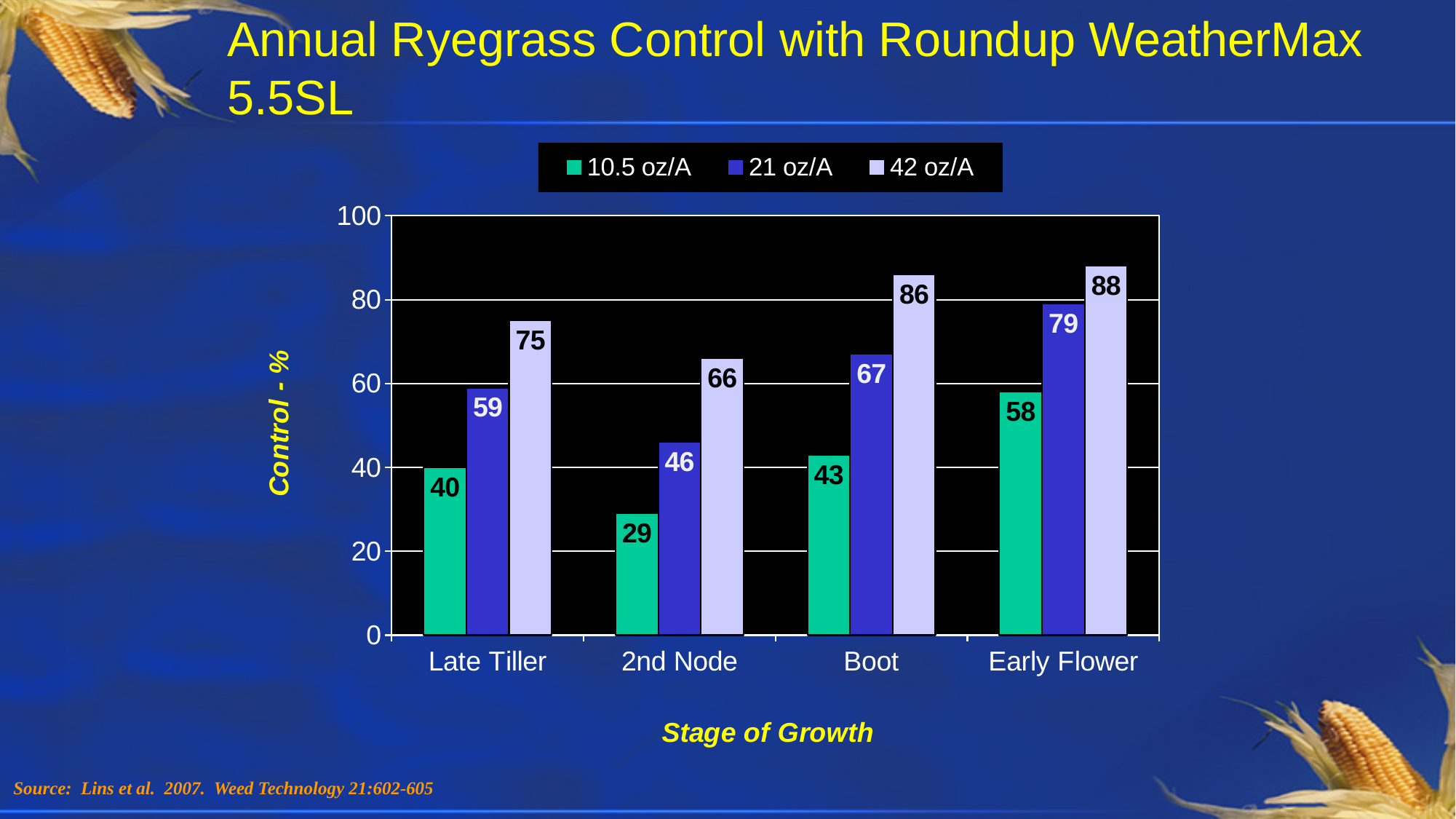
What is the label of the y axis? Control - % Which stage of growth has the lowest control value for the 10.5 oz/A rate? 2nd Node Which stage of growth has the highest control value for the 42 oz/A rate? Early Flower What is the control value for the 42 oz/A rate at the Late Tiller stage? 75 How many series does the legend list? 3 Which is larger: the 21 oz/A value at Late Tiller or the 10.5 oz/A value at Early Flower? 21 oz/A at Late Tiller What is the control value for the 10.5 oz/A rate at the 2nd Node stage? 29 What kind of chart is shown on the slide? Bar chart How many stages of growth are shown on the x axis? 4 What is the difference between the 42 oz/A and 10.5 oz/A control values at the Early Flower stage? 30 Does the control value for the 21 oz/A rate rise or fall from the 2nd Node stage to the Early Flower stage? Rise What is the control value for the 21 oz/A rate at the Boot stage? 67